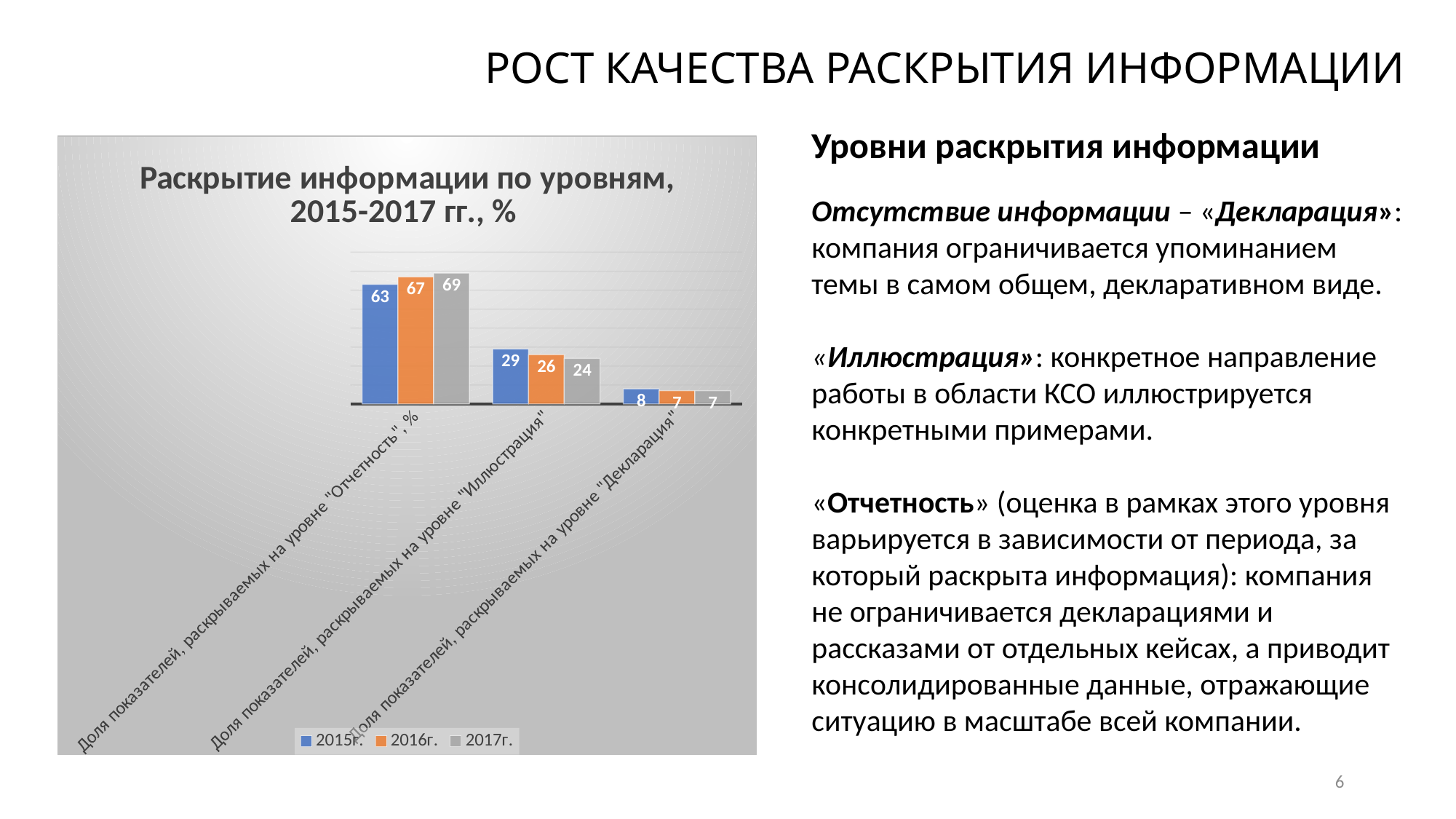
Do the values at the "Отчетность" level rise or fall from 2015г. to 2017г.? rise How many series does the legend list? 3 Which is larger at the "Иллюстрация" level: the value for 2015г. or for 2017г.? 2015г. What type of chart is shown on the slide? bar chart Which level has the highest value for 2017г.? Отчетность What is the title of the chart? Раскрытие информации по уровням, 2015-2017 гг., % How many categories (levels) are shown on the x axis? 3 What is the value for 2017г. at the "Иллюстрация" level? 24 What is the value for 2016г. at the "Декларация" level? 7 Which level has the lowest value for 2015г.? Декларация What is the value for 2015г. at the "Отчетность" level? 63 What is the difference between the 2017г. and 2015г. values at the "Отчетность" level? 6